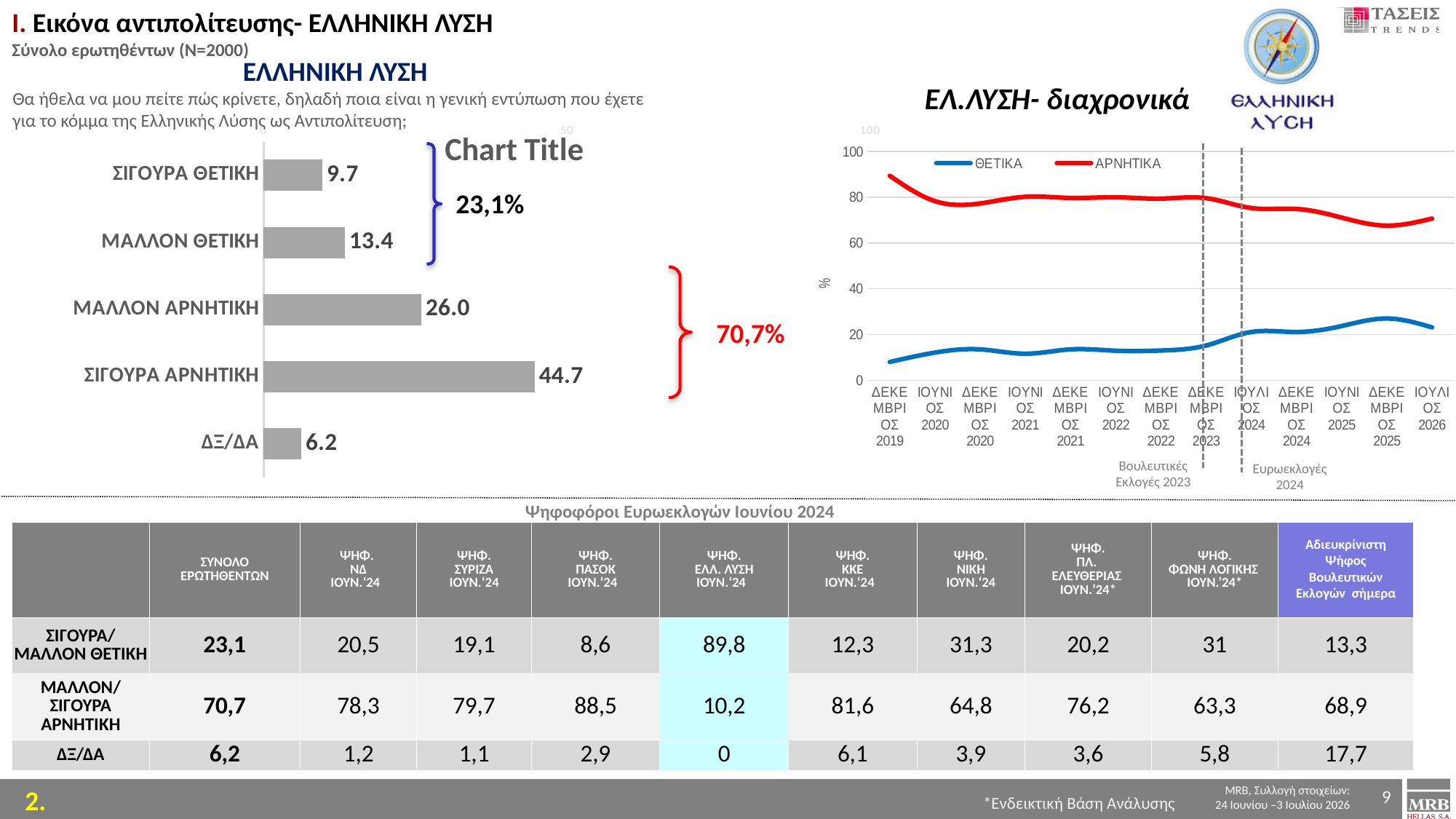
In the bar chart on the left, what is the value for ΣΙΓΟΥΡΑ ΑΡΝΗΤΙΚΗ? 44.7 In the chart titled ΕΛ.ΛΥΣΗ- διαχρονικά, which series is shown in red? ΑΡΝΗΤΙΚΑ In the bar chart on the left, what is the difference between ΣΙΓΟΥΡΑ ΑΡΝΗΤΙΚΗ and ΜΑΛΛΟΝ ΑΡΝΗΤΙΚΗ? 18.7 How many series does the legend of the chart titled ΕΛ.ΛΥΣΗ- διαχρονικά list? 2 In the bar chart on the left, which category has the lowest value? ΔΞ/ΔΑ In the chart titled ΕΛ.ΛΥΣΗ- διαχρονικά, is the ΑΡΝΗΤΙΚΑ value for ΔΕΚΕΜΒΡΙΟΣ 2019 greater or less than 80? greater What kind of chart is the chart on the left? bar chart In the bar chart on the left, which category has the highest value? ΣΙΓΟΥΡΑ ΑΡΝΗΤΙΚΗ In the bar chart on the left, which is larger: ΣΙΓΟΥΡΑ ΘΕΤΙΚΗ or ΜΑΛΛΟΝ ΘΕΤΙΚΗ? ΜΑΛΛΟΝ ΘΕΤΙΚΗ In the bar chart on the left, what is the value for ΜΑΛΛΟΝ ΘΕΤΙΚΗ? 13.4 How many categories does the bar chart on the left show? 5 In the bar chart on the left, what is the value for ΔΞ/ΔΑ? 6.2